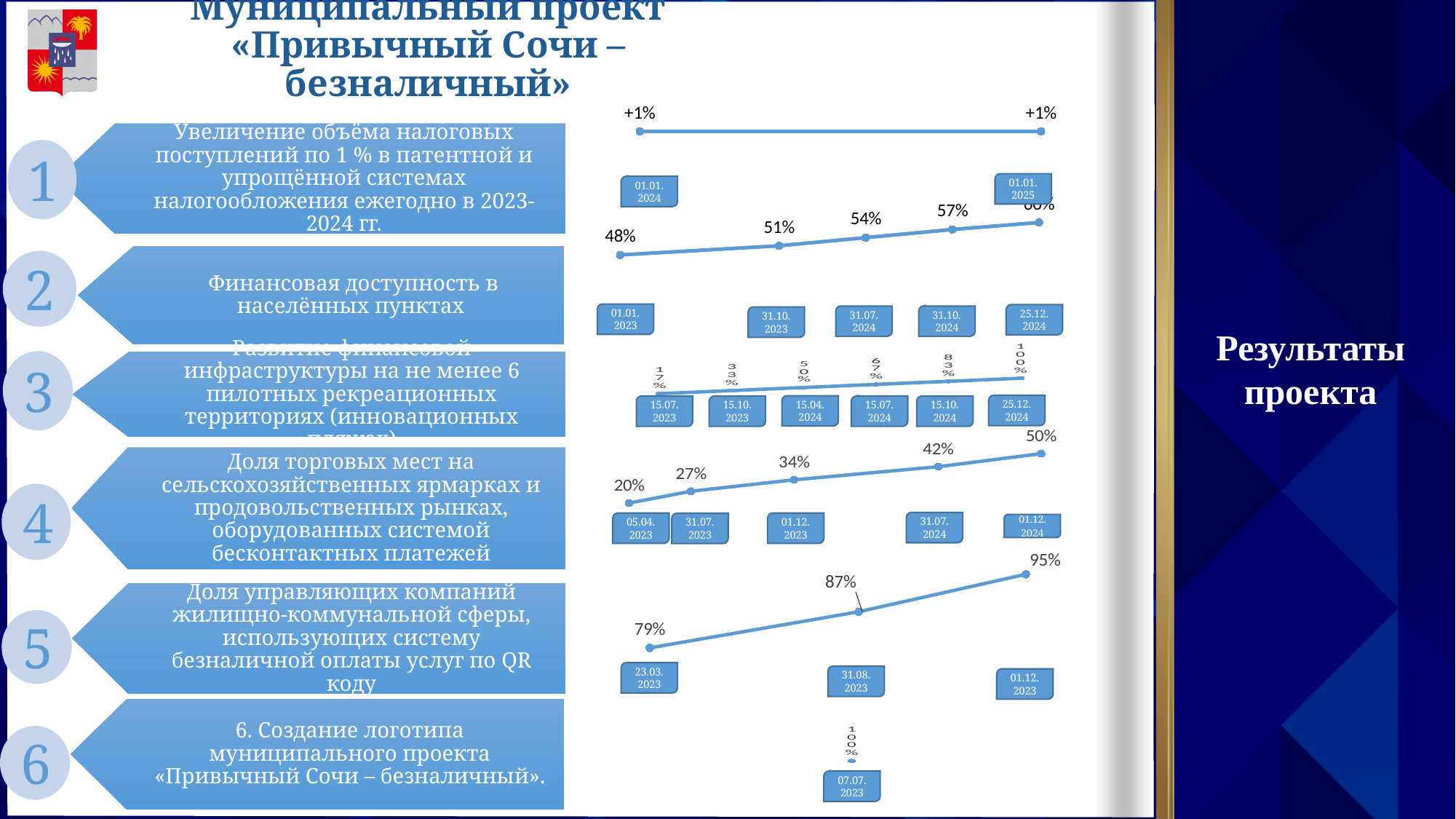
In the chart next to item 2 (financial accessibility), what value is shown for 01.01.2023? 48% In the chart next to item 3 (financial infrastructure on pilot territories), what value is shown for 25.12.2024? 100% In the chart next to item 4 (share of trading places at fairs and markets), what value is shown for 01.12.2023? 34% In the chart next to item 2 (financial accessibility), what value is shown for 31.07.2024? 54% In the chart next to item 5 (management companies using QR payment), what value is shown for 31.08.2023? 87% In the chart next to item 1 (tax revenue increase), what value is shown for 01.01.2025? +1% In the chart next to item 2 (financial accessibility), what is the difference between the values for 31.10.2024 and 31.10.2023? 6% In the chart next to item 4 (share of trading places at fairs and markets), which date has the highest value? 01.12.2024 In the chart next to item 3 (financial infrastructure on pilot territories), how many data points are plotted? 6 In the chart next to item 4 (share of trading places at fairs and markets), what is the difference between the values for 01.12.2024 and 05.04.2023? 30% What kind of chart is used next to item 5 (management companies using QR payment)? line chart In the chart next to item 5 (management companies using QR payment), do the values rise or fall over time? rise